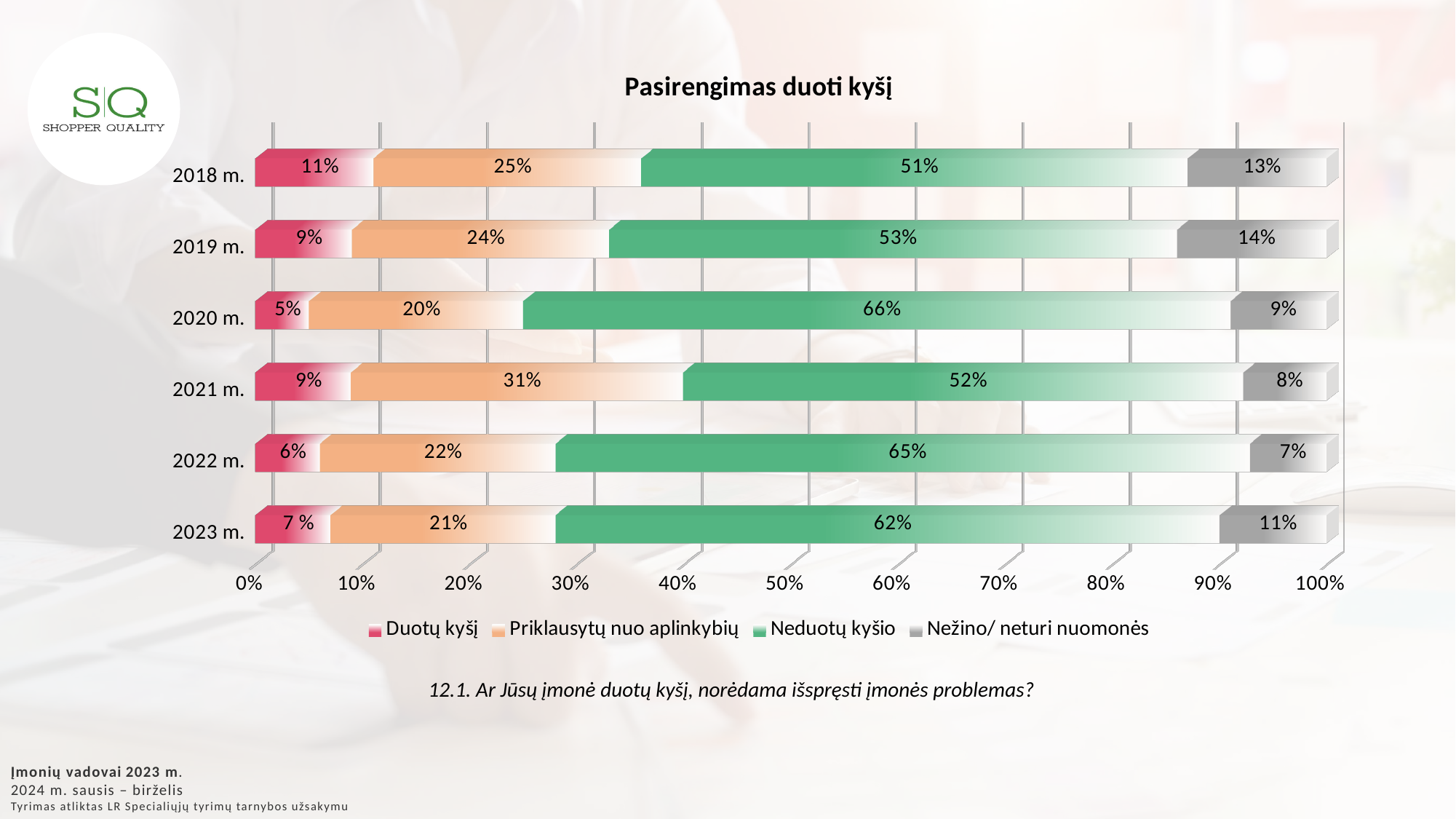
In which year is the 'Duotų kyšį' value lowest? 2020 m. How many years (categories) are shown on the chart? 6 How many series does the legend list? 4 In which year is the 'Neduotų kyšio' value highest? 2020 m. What is the value for 'Duotų kyšį' in 2018 m.? 11% What is the value for 'Neduotų kyšio' in 2020 m.? 66% What is the difference between the 'Neduotų kyšio' values for 2022 m. and 2023 m.? 3% Which is larger: the 'Nežino/ neturi nuomonės' value for 2019 m. or for 2021 m.? 2019 m. What type of chart is shown on the slide? Stacked bar chart What is the title of the chart? Pasirengimas duoti kyšį What is the value for 'Priklausytų nuo aplinkybių' in 2021 m.? 31% What is the value for 'Nežino/ neturi nuomonės' in 2023 m.? 11%